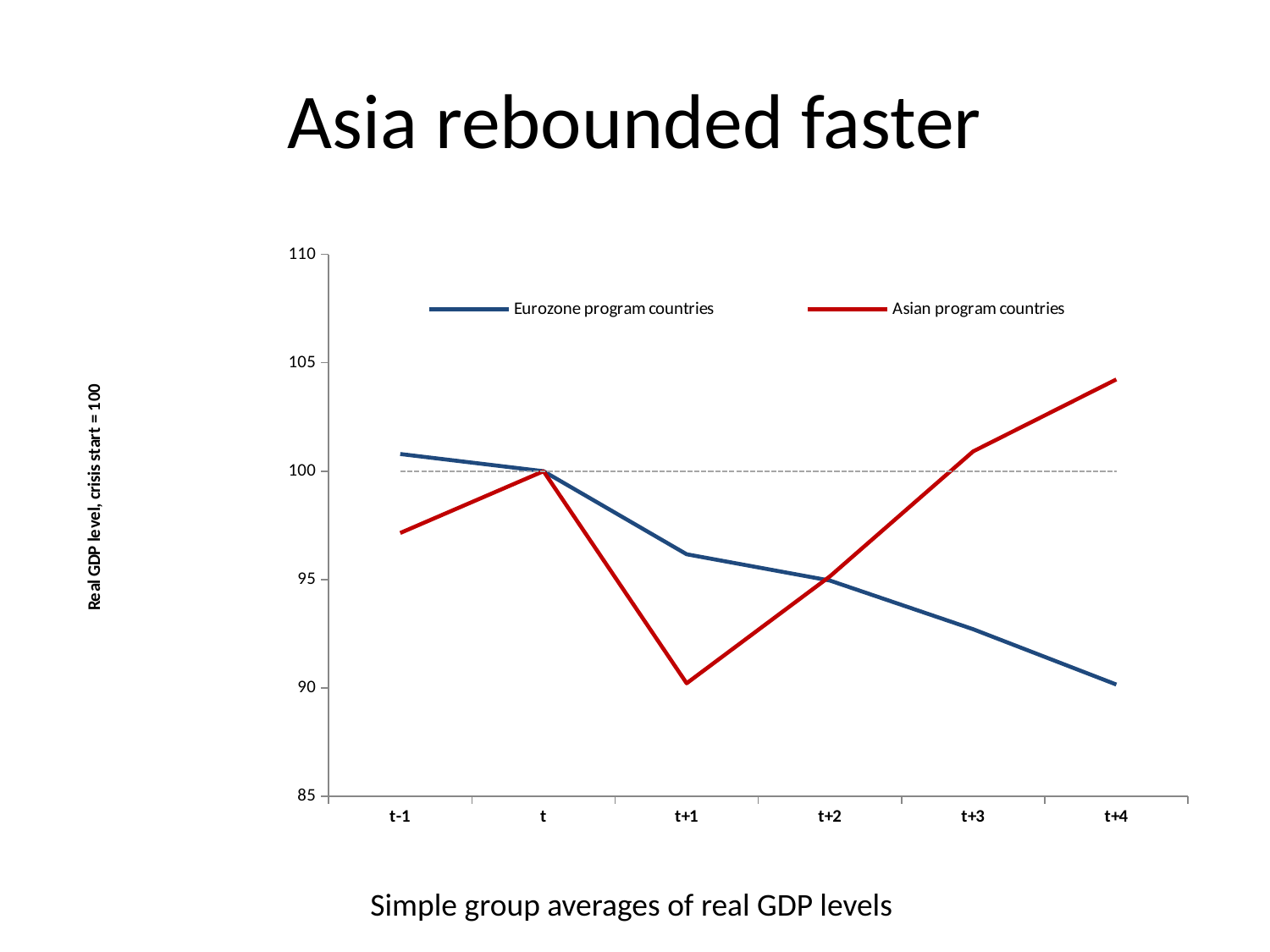
How many time points are shown on the x axis? 6 What is the value for Asian program countries at t? 100 Is the value for Asian program countries at t+4 greater or less than 100? greater At t+4, which series has the higher value, Eurozone program countries or Asian program countries? Asian program countries What is the title of the slide? Asia rebounded faster What kind of chart is shown on the slide? line chart How many series does the legend list? 2 Do the values for Eurozone program countries rise or fall from t to t+4? fall Is the value for Asian program countries at t+1 greater or less than 95? less Is the value for Eurozone program countries at t+4 greater or less than 95? less At t-1, which series has the higher value, Eurozone program countries or Asian program countries? Eurozone program countries At which time point is the value for Asian program countries lowest? t+1